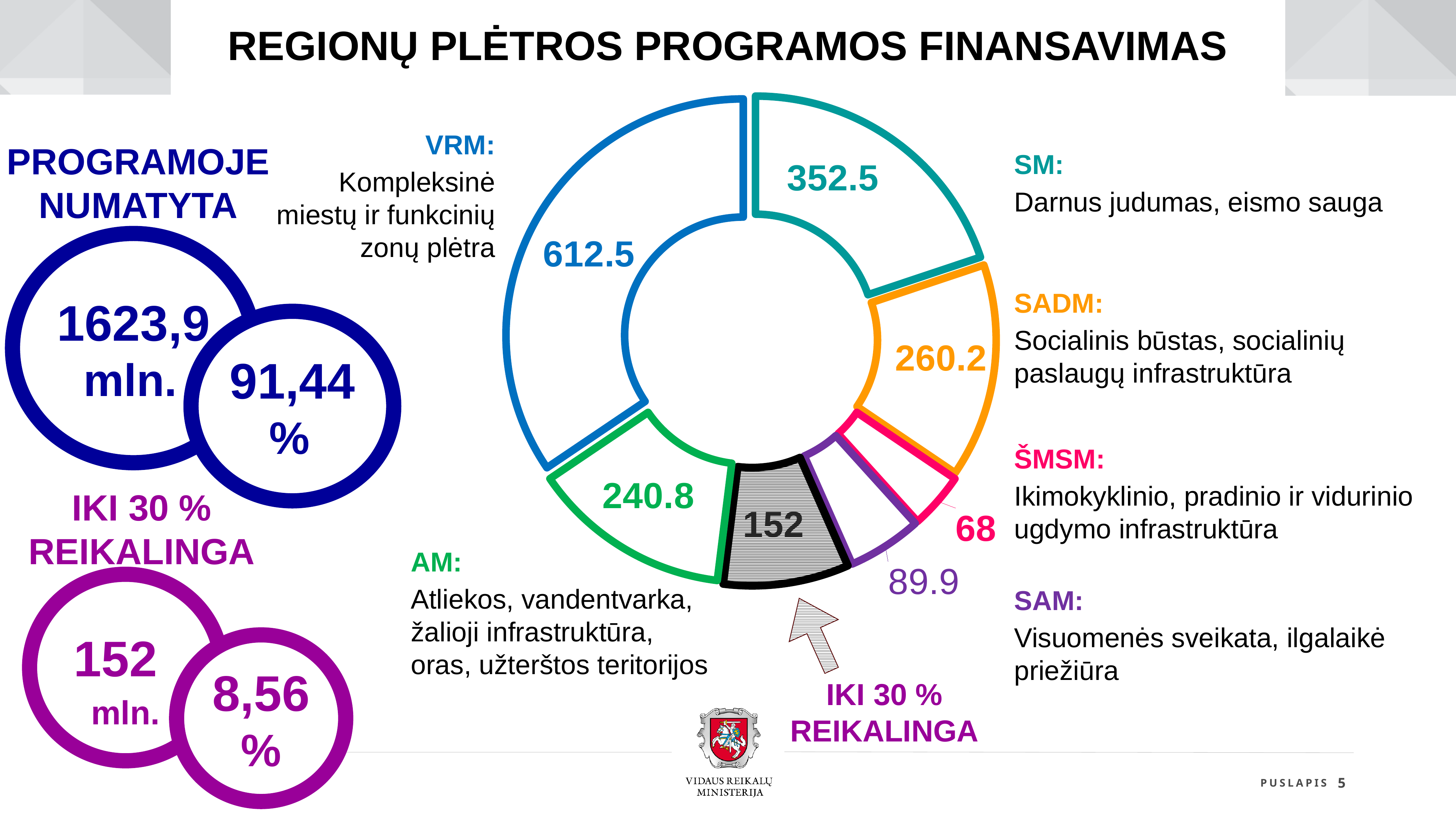
Which segment of the doughnut chart has the largest value? VRM (612.5) What is the value of the SADM segment? 260.2 What is the difference between the VRM segment and the SM segment? 260 Which is larger, the SADM segment or the AM segment? SADM (260.2) What is the value of the AM segment? 240.8 Which segment of the doughnut chart has the smallest value? ŠMSM (68) What is the value of the SM segment (Darnus judumas, eismo sauga)? 352.5 What is the value of the SAM segment? 89.9 What kind of chart is shown on the slide? Doughnut (pie) chart How many segments does the doughnut chart have? 7 What is the value of the ŠMSM segment? 68 What is the value of the VRM segment in the doughnut chart? 612.5